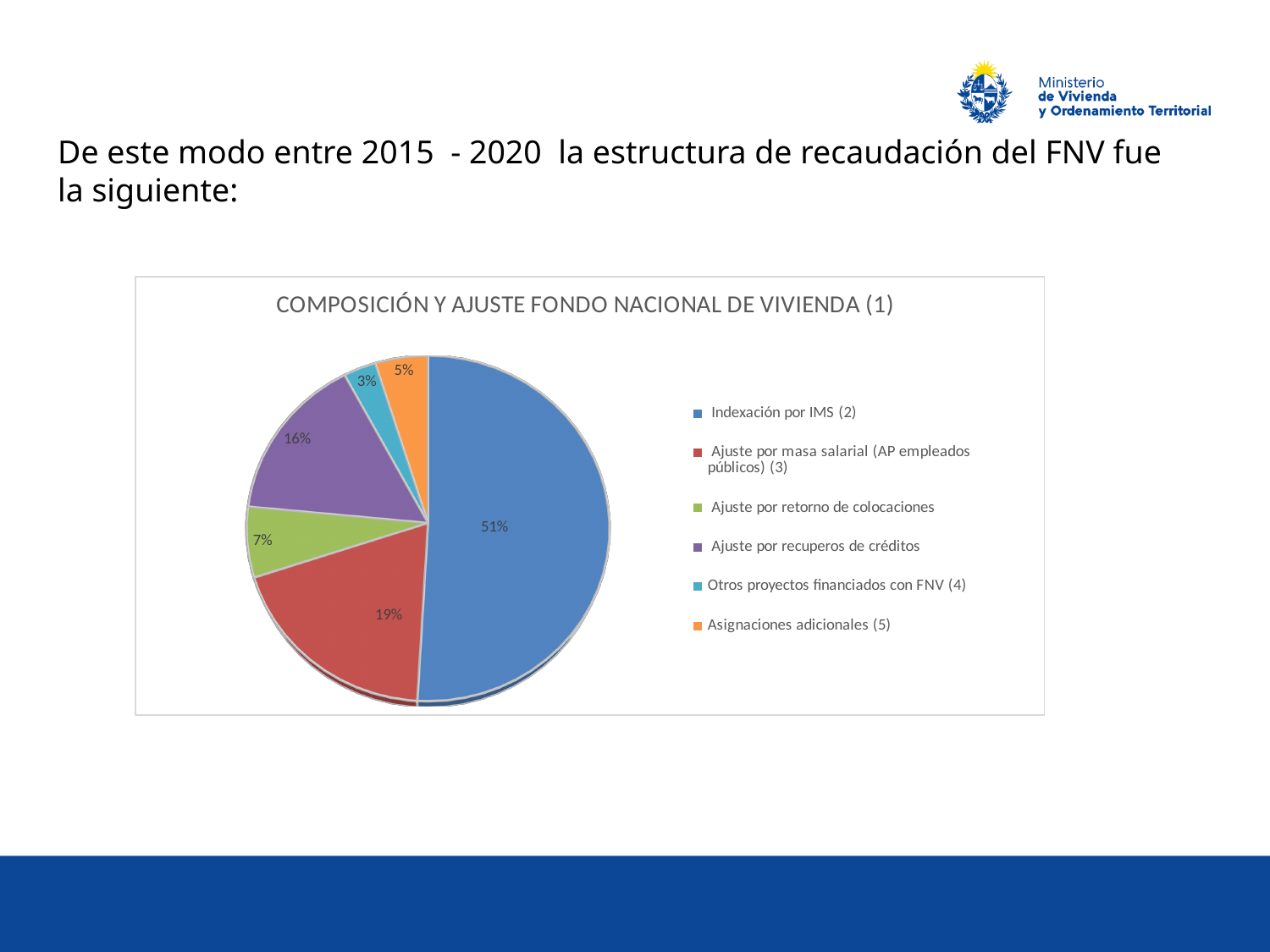
What percentage is shown for Ajuste por retorno de colocaciones? 7% Which is larger, the share for Ajuste por retorno de colocaciones or the share for Asignaciones adicionales (5)? Ajuste por retorno de colocaciones What is the difference in percentage points between Ajuste por masa salarial (AP empleados públicos) (3) and Ajuste por recuperos de créditos? 3 What percentage is shown for Asignaciones adicionales (5)? 5% Which category has the smallest share of the pie? Otros proyectos financiados con FNV (4) How many categories does the legend list? 6 What percentage is shown for Ajuste por recuperos de créditos? 16% What percentage is shown for Ajuste por masa salarial (AP empleados públicos) (3)? 19% What share of the pie does Indexación por IMS (2) represent? 51% Which category has the largest share of the pie? Indexación por IMS (2) What type of chart is shown on the slide? Pie chart What percentage is shown for Otros proyectos financiados con FNV (4)? 3%